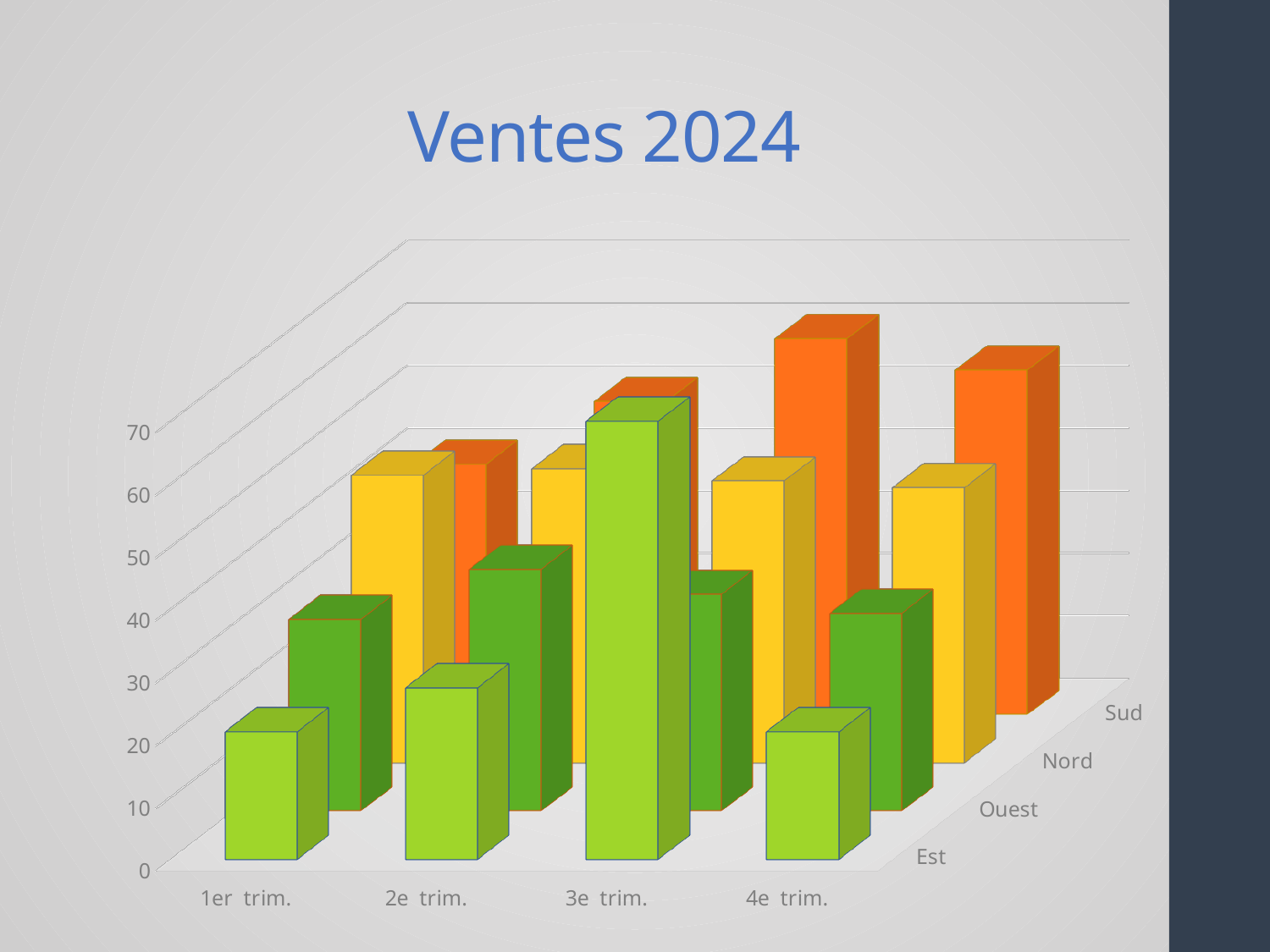
What is the title of the chart? Ventes 2024 Is the value for Est in 1er trim. greater or less than 40? less Is the value for Est in 3e trim. greater or less than 40? greater Is the value for Sud in 3e trim. greater or less than 40? greater For the Sud series, which is larger: the value in 1er trim. or the value in 3e trim.? 3e trim. Which is larger for Est: the value in 2e trim. or the value in 3e trim.? 3e trim. Which region's bars are coloured orange? Sud For the Est series, which quarter has the highest value? 3e trim. How many regions (series) are plotted in the chart? 4 In 1er trim., which is larger: the value for Est or the value for Ouest? Ouest How many quarters (categories) are shown on the x axis? 4 What kind of chart is shown on the slide? bar chart